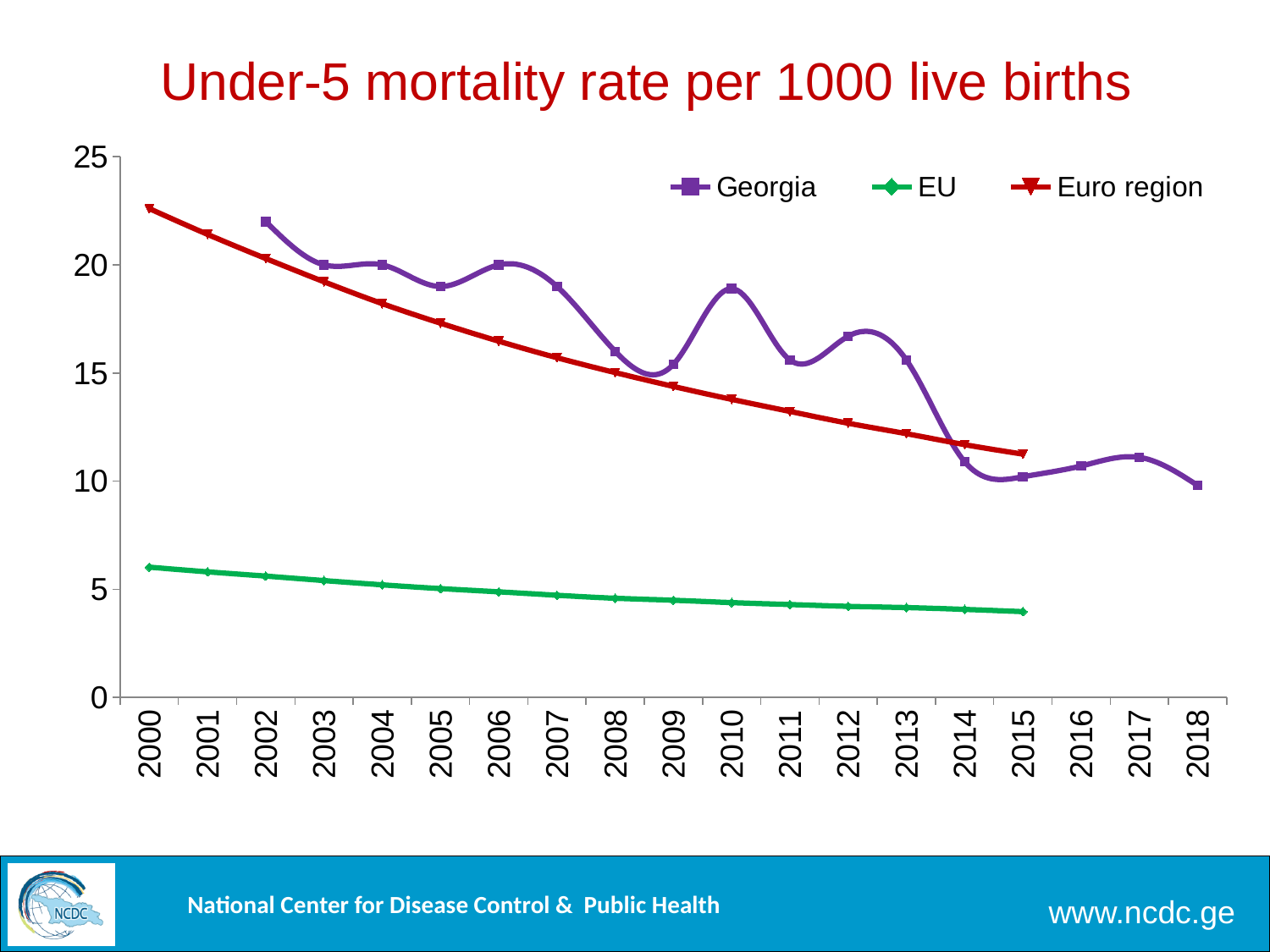
Which is larger in 2010, the value for Georgia or the value for Euro region? Georgia Does the Euro region line rise or fall from 2000 to 2015? Fall What is the title of the chart? Under-5 mortality rate per 1000 live births How many series does the legend list? 3 Is the value for Georgia in 2002 greater or less than 20? greater Which series are listed in the legend? Georgia, EU, Euro region Is the value for EU in 2015 greater or less than 5? less Which series has the lowest values across the whole chart? EU Does the EU line rise or fall from 2000 to 2015? Fall How many years are shown on the x axis? 19 Is the value for Georgia in 2010 greater or less than 15? greater What kind of chart is shown on the slide? Line chart